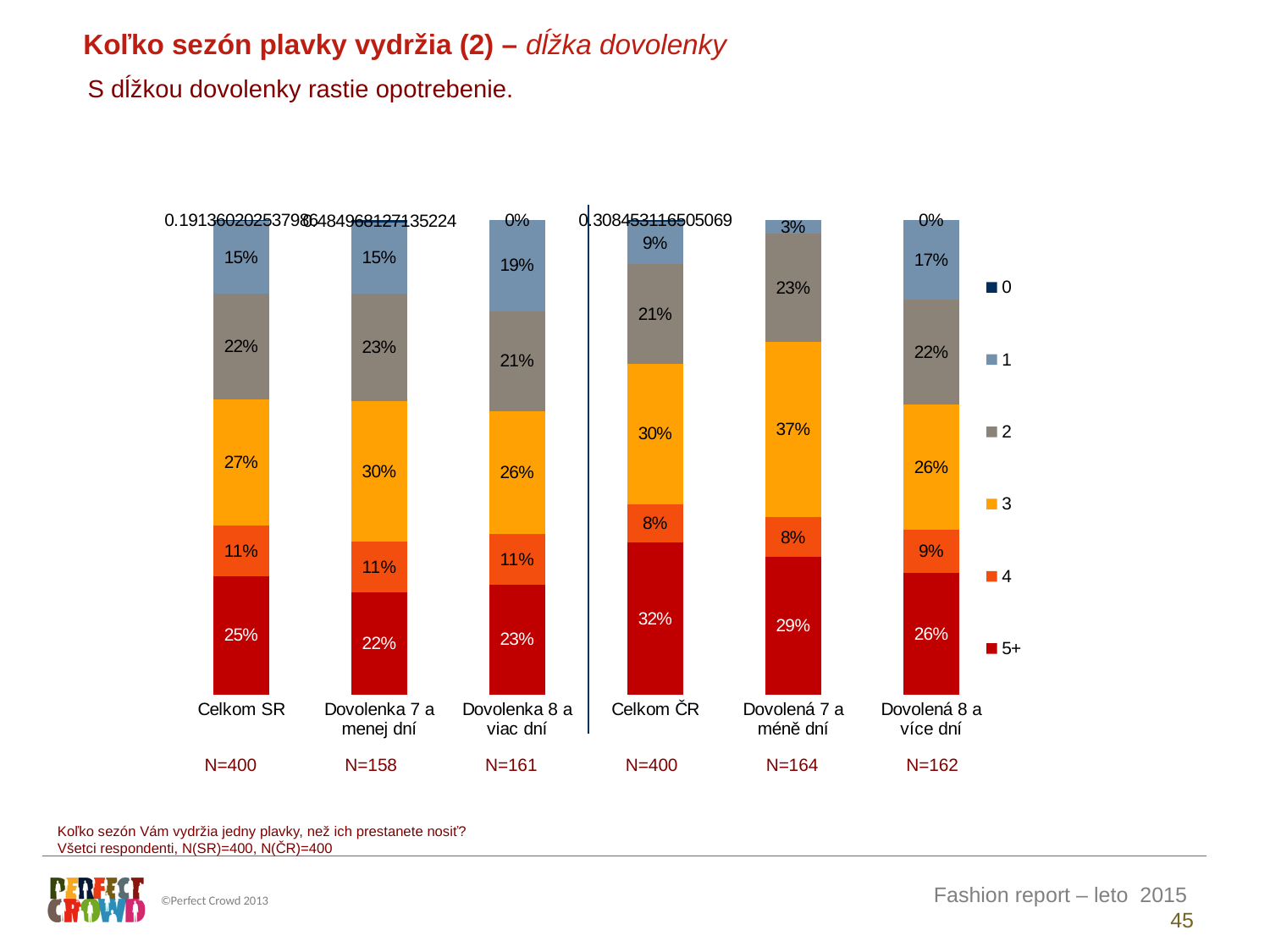
What kind of chart is shown on the slide? stacked bar chart Which category has the lowest value for the '1' segment? Dovolená 7 a méně dní What is the value of the '3' segment for Dovolená 7 a méně dní? 37% What is the value of the '4' segment for Celkom SR? 11% What is the sample size (N) shown under the Dovolená 8 a více dní bar? N=162 What is the difference between the '3' segment for Dovolená 7 a méně dní and the '3' segment for Celkom SR? 10% What is the value of the '1' segment for Dovolenka 8 a viac dní? 19% How many series does the legend list? 6 How many categories (bars) are plotted on the chart? 6 What is the value of the '5+' segment for Celkom ČR? 32% Which category has the highest value for the '5+' segment? Celkom ČR Which is larger: the '2' segment for Dovolenka 7 a menej dní or the '2' segment for Dovolenka 8 a viac dní? Dovolenka 7 a menej dní